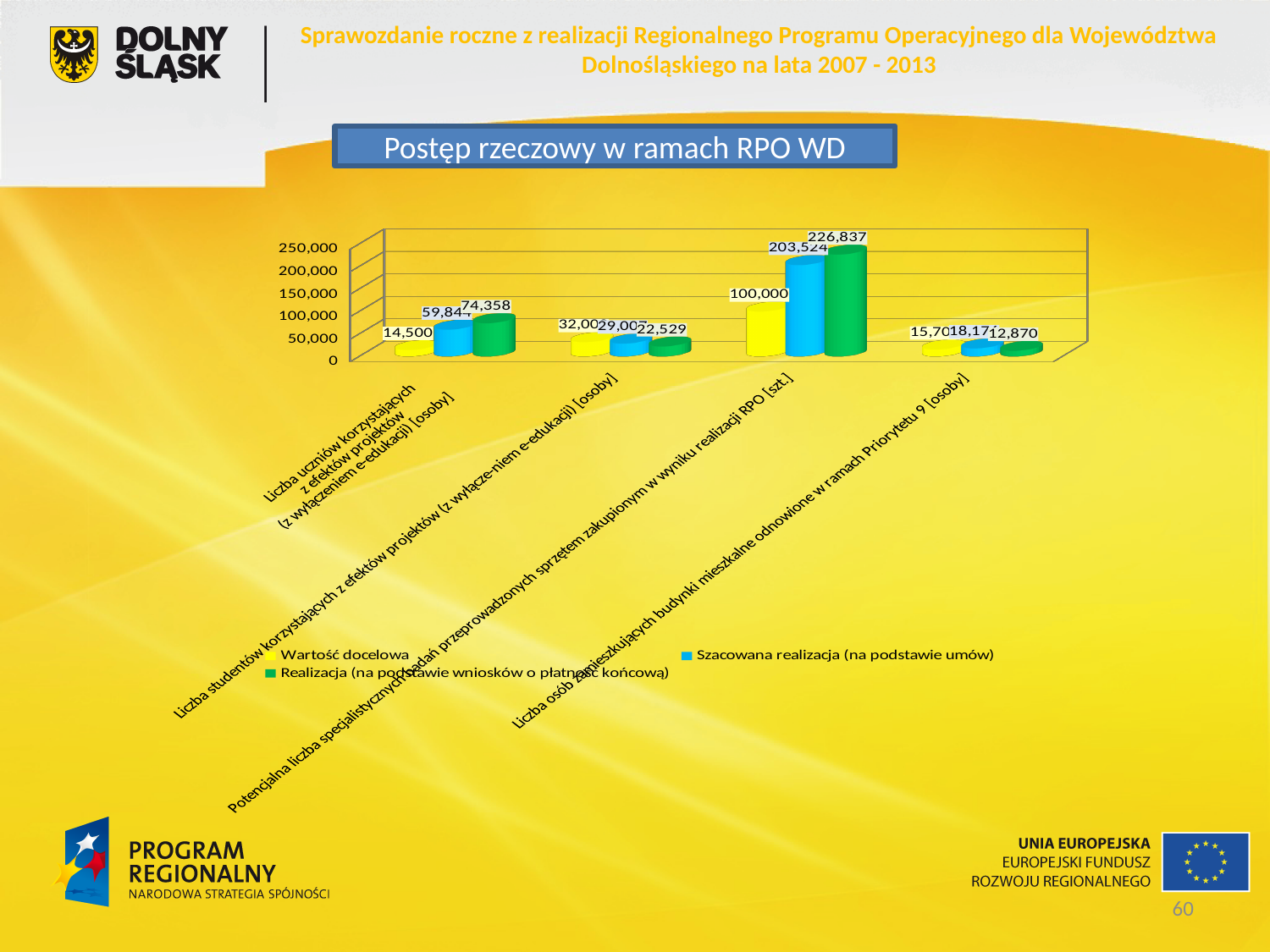
What is the Szacowana realizacja (na podstawie umów) value for 'Potencjalna liczba specjalistycznych badań przeprowadzonych sprzętem zakupionym w wyniku realizacji RPO [szt.]'? 203,524 What kind of chart is shown on the slide? Bar chart For 'Potencjalna liczba specjalistycznych badań przeprowadzonych sprzętem zakupionym w wyniku realizacji RPO [szt.]', how much higher is the Realizacja (na podstawie wniosków o płatność końcową) value than the Wartość docelowa value? 126,837 What is the Wartość docelowa value for 'Liczba studentów korzystających z efektów projektów (z wyłączeniem e-edukacji) [osoby]'? 32,000 What is the Realizacja (na podstawie wniosków o płatność końcową) value for 'Liczba uczniów korzystających z efektów projektów (z wyłączeniem e-edukacji) [osoby]'? 74,358 For 'Potencjalna liczba specjalistycznych badań przeprowadzonych sprzętem zakupionym w wyniku realizacji RPO [szt.]', what is the difference between the Realizacja (na podstawie wniosków o płatność końcową) value and the Szacowana realizacja (na podstawie umów) value? 23,313 How many series does the chart legend list? 3 What is the Realizacja (na podstawie wniosków o płatność końcową) value for 'Liczba studentów korzystających z efektów projektów (z wyłączeniem e-edukacji) [osoby]'? 22,529 For 'Liczba studentów korzystających z efektów projektów (z wyłączeniem e-edukacji) [osoby]', which is larger: the Wartość docelowa value or the Realizacja (na podstawie wniosków o płatność końcową) value? Wartość docelowa What is the Realizacja (na podstawie wniosków o płatność końcową) value for 'Liczba osób zamieszkujących budynki mieszkalne odnowione w ramach Priorytetu 9 [osoby]'? 12,870 Which category has the highest Realizacja (na podstawie wniosków o płatność końcową) value? Potencjalna liczba specjalistycznych badań przeprowadzonych sprzętem zakupionym w wyniku realizacji RPO [szt.] What is the Wartość docelowa value for 'Liczba uczniów korzystających z efektów projektów (z wyłączeniem e-edukacji) [osoby]'? 14,500